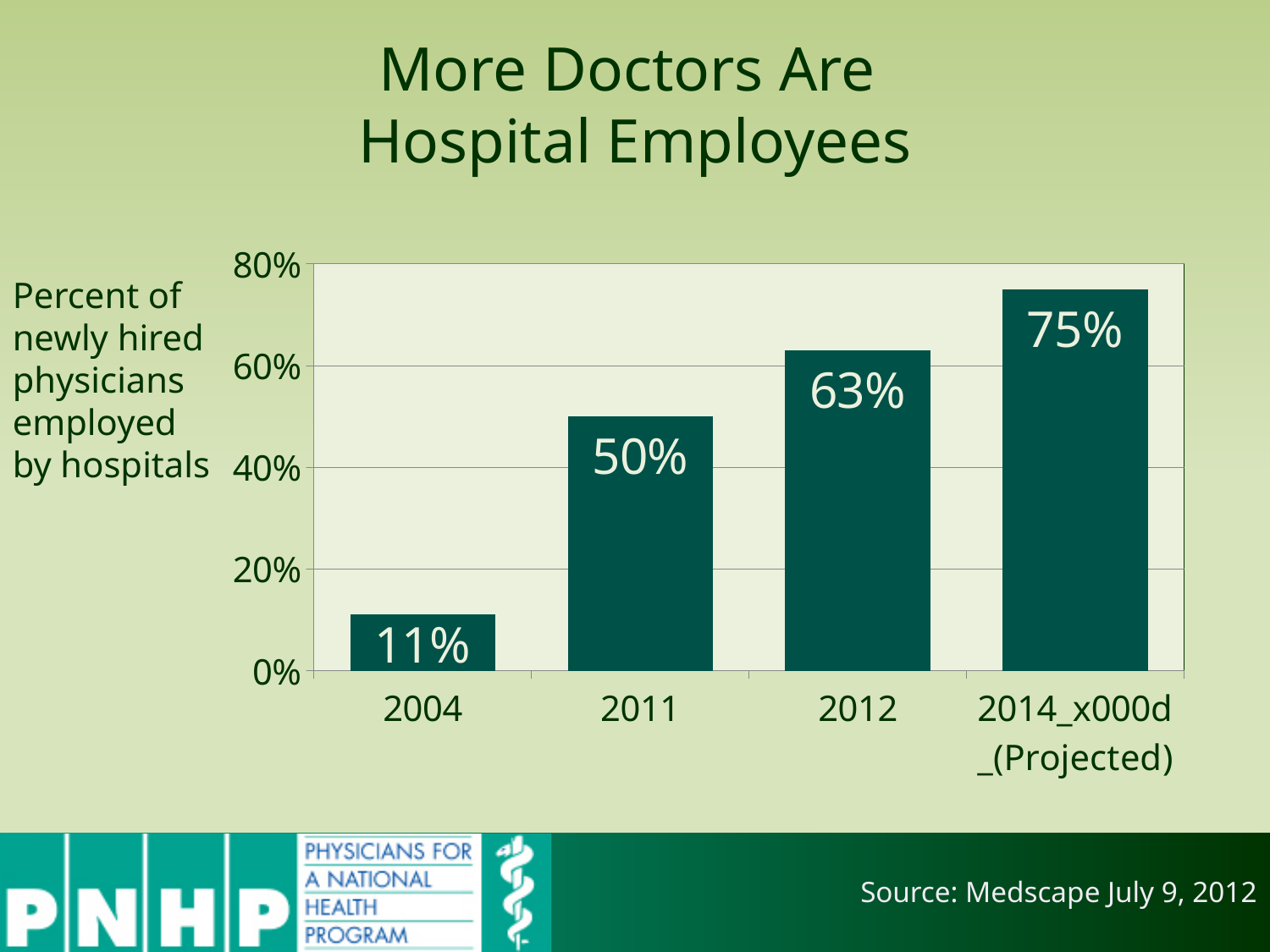
What is the value shown for 2012? 63% What kind of chart is shown on the slide? Bar chart What is the projected value shown for 2014? 75% How many bars are shown on the chart? 4 Which year has the lowest value on the chart? 2004 Do the values rise or fall from 2004 to 2014 (Projected)? Rise Which year has the highest value on the chart? 2014 (Projected) What is the value shown for 2011? 50% What percent of newly hired physicians were employed by hospitals in 2004? 11% Which is larger, the value for 2011 or the value for 2012? 2012 What is the difference between the 2012 value and the 2011 value? 13% What is the difference between the 2014 projected value and the 2004 value? 64%